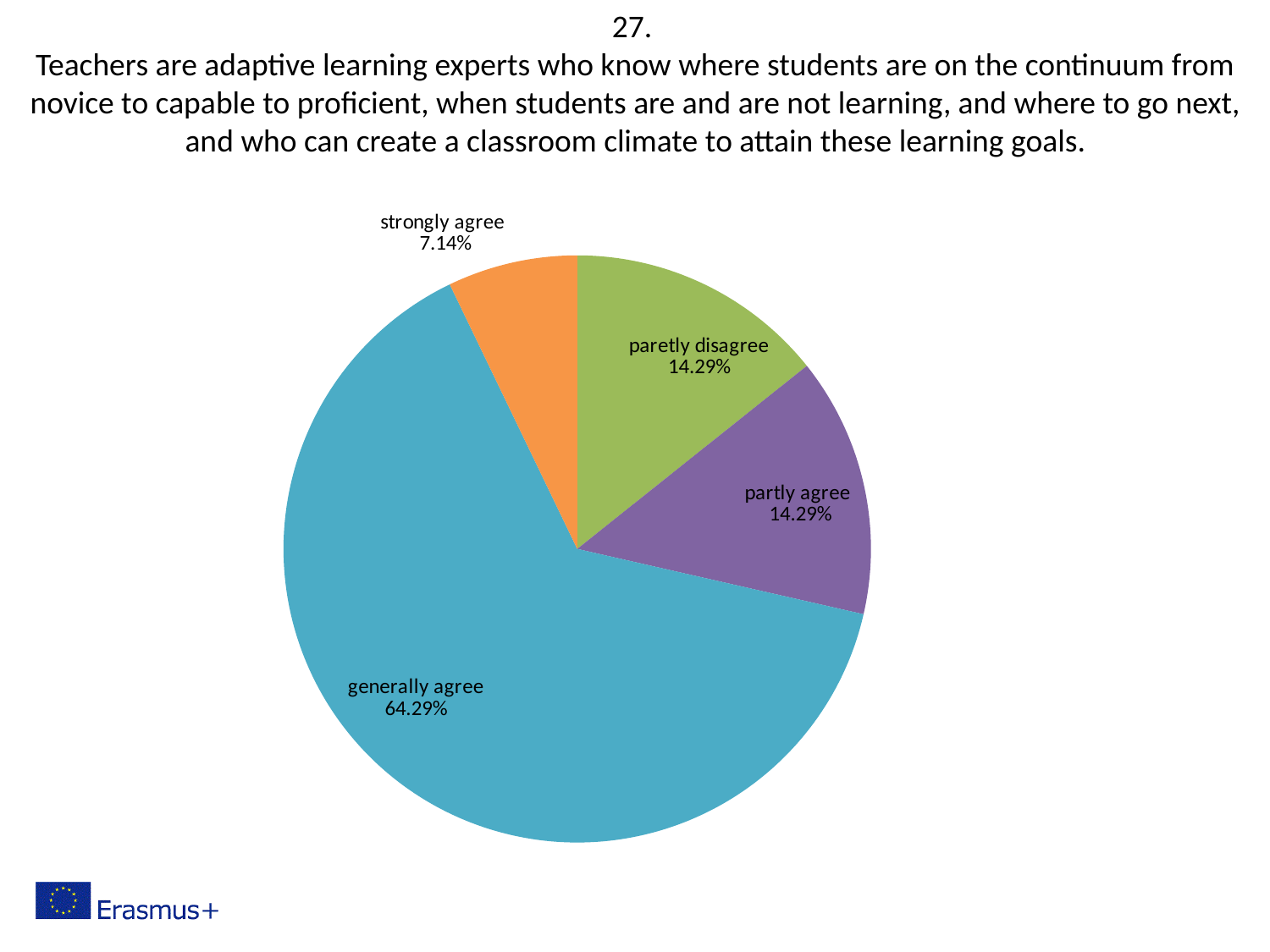
What is the difference in percentage points between "generally agree" and "strongly agree"? 57.15 What share of the pie is labelled "partly agree"? 14.29% What share of the pie is labelled "paretly disagree"? 14.29% How many slices does the pie chart have? 4 What share of the pie is labelled "strongly agree"? 7.14% What colour is the "generally agree" slice? blue Which response category has the smallest slice of the pie? strongly agree What is the combined share of "partly agree" and "paretly disagree"? 28.58% What kind of chart is shown on the slide? pie chart Which response category has the largest slice of the pie? generally agree What share of the pie is labelled "generally agree"? 64.29% Which is larger, the "partly agree" slice or the "strongly agree" slice? partly agree